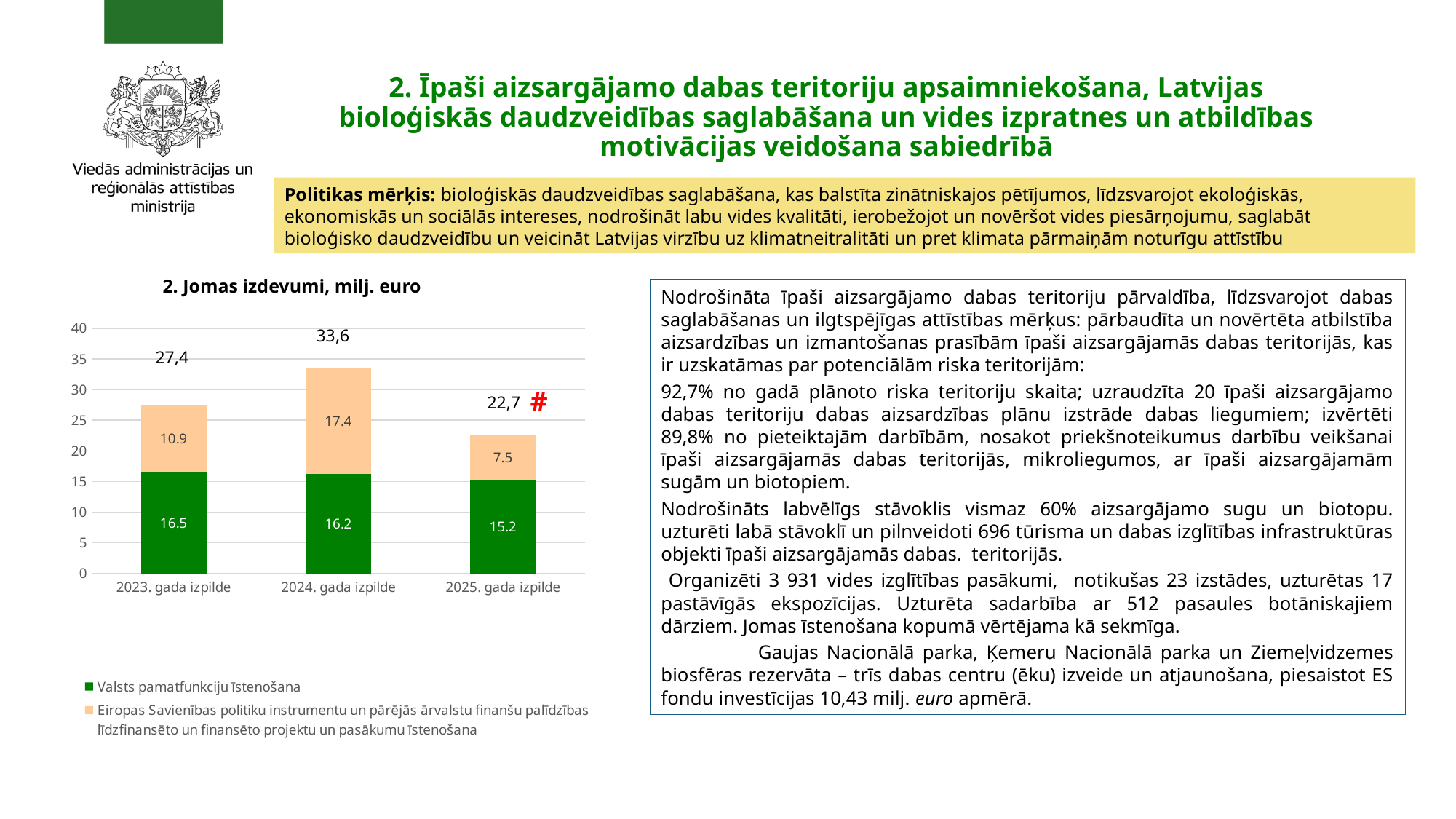
What is the value of the 'Eiropas Savienības politiku instrumentu...' series for 2023. gada izpilde? 10.9 What is the difference between the total for 2024. gada izpilde and the total for 2025. gada izpilde? 10,9 How many categories are shown on the x axis of the chart? 3 What is the title of the chart? 2. Jomas izdevumi, milj. euro How many series does the chart legend list? 2 Which year has the highest total expenditure? 2024. gada izpilde What type of chart is shown on the slide? stacked bar chart Is the 'Eiropas Savienības...' value larger in 2024. gada izpilde or in 2025. gada izpilde? 2024. gada izpilde What is the total shown above the bar for 2025. gada izpilde? 22,7 What is the value of 'Valsts pamatfunkciju īstenošana' for 2024. gada izpilde? 16.2 Is the total for 2023. gada izpilde greater or less than 25? greater Which year has the lowest value for 'Valsts pamatfunkciju īstenošana'? 2025. gada izpilde